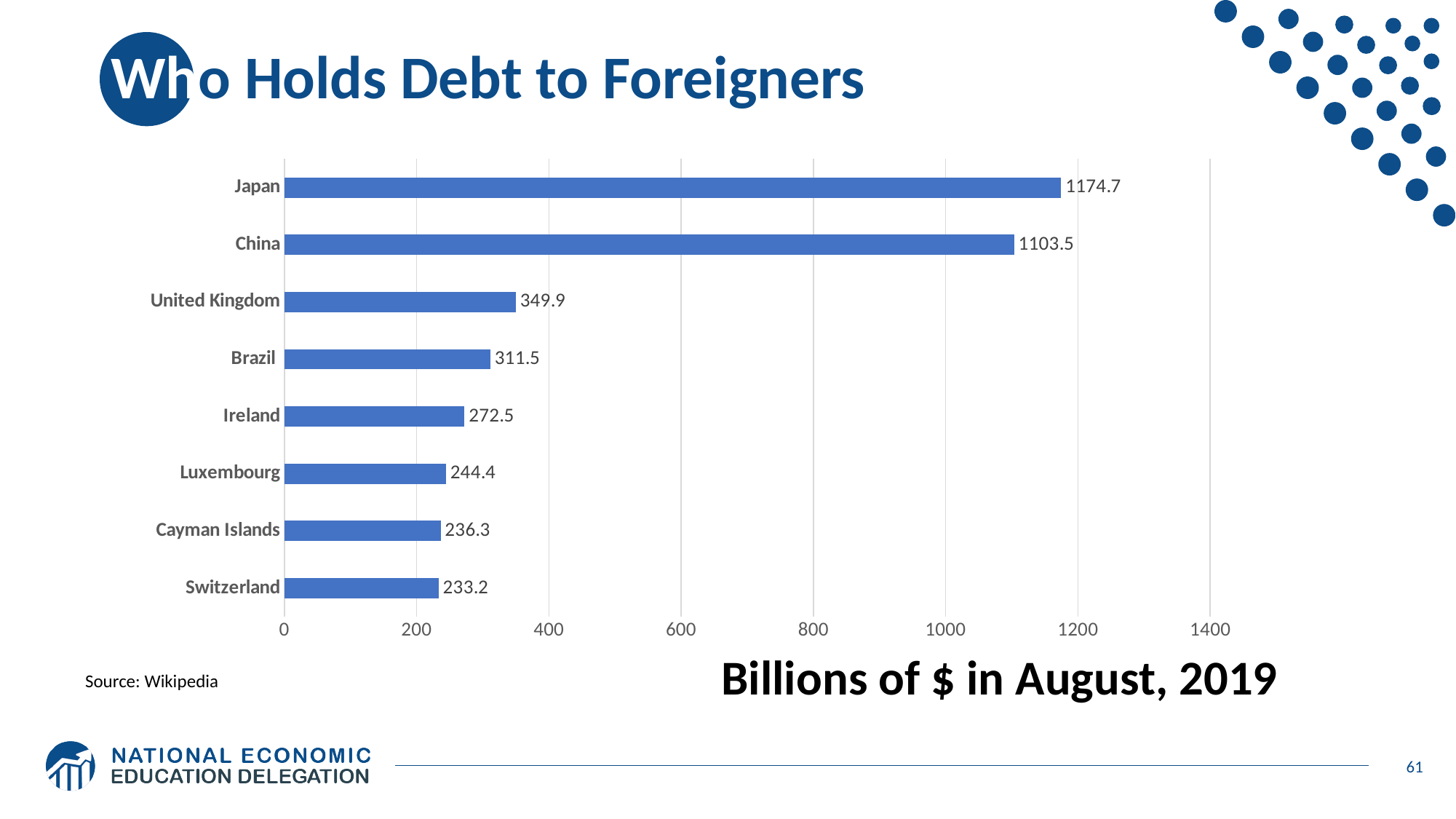
What is the value for Cayman Islands? 236.3 What kind of chart is shown on the slide? bar chart What unit does the chart's caption say the values are in? Billions of $ in August, 2019 Which country has the highest value? Japan What is the difference between the values for United Kingdom and Brazil? 38.4 What is the value for Japan? 1174.7 What is the difference between the values for Japan and China? 71.2 Is the value for China greater or less than 1000? greater Which is larger, the value for Ireland or the value for Luxembourg? Ireland What is the value for United Kingdom? 349.9 How many countries are shown in the chart? 8 Which country has the lowest value? Switzerland